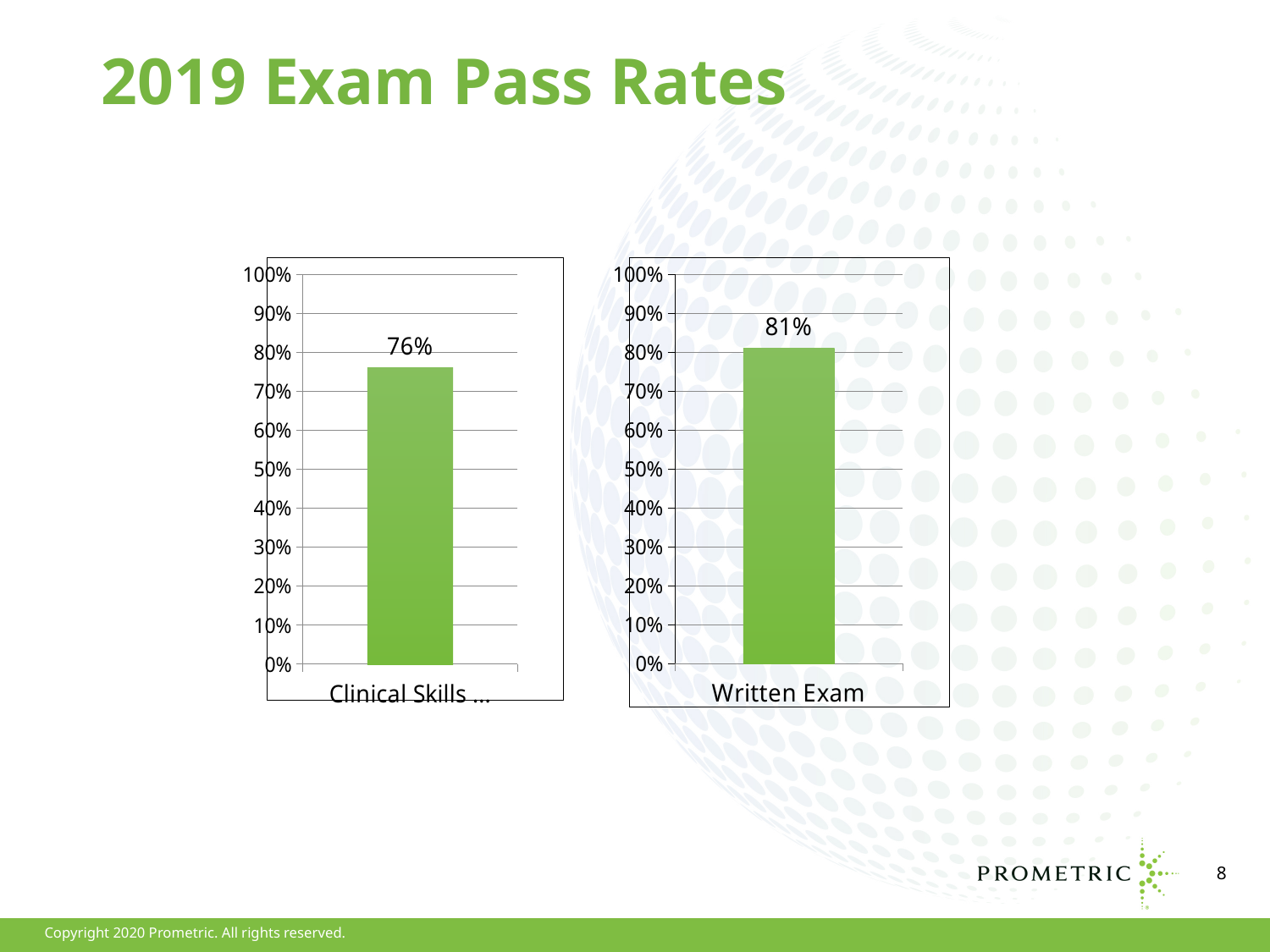
In the right chart, is the value for Written Exam greater or less than 80%? greater Which has the higher pass rate: the Clinical Skills bar in the left chart or the Written Exam bar in the right chart? Written Exam What kind of chart is the left chart? bar chart In the right chart, what is the pass rate shown for Written Exam? 81% How many bars are plotted in the left chart? 1 What is the difference between the Written Exam pass rate in the right chart and the Clinical Skills pass rate in the left chart? 5% In the left chart, is the value for Clinical Skills greater or less than 80%? less What is the maximum value shown on the y axis of the right chart? 100% What kind of chart is the right chart? bar chart What colour are the bars in both charts? green How many bars are plotted in the right chart? 1 In the left chart, what is the pass rate shown for the Clinical Skills bar? 76%